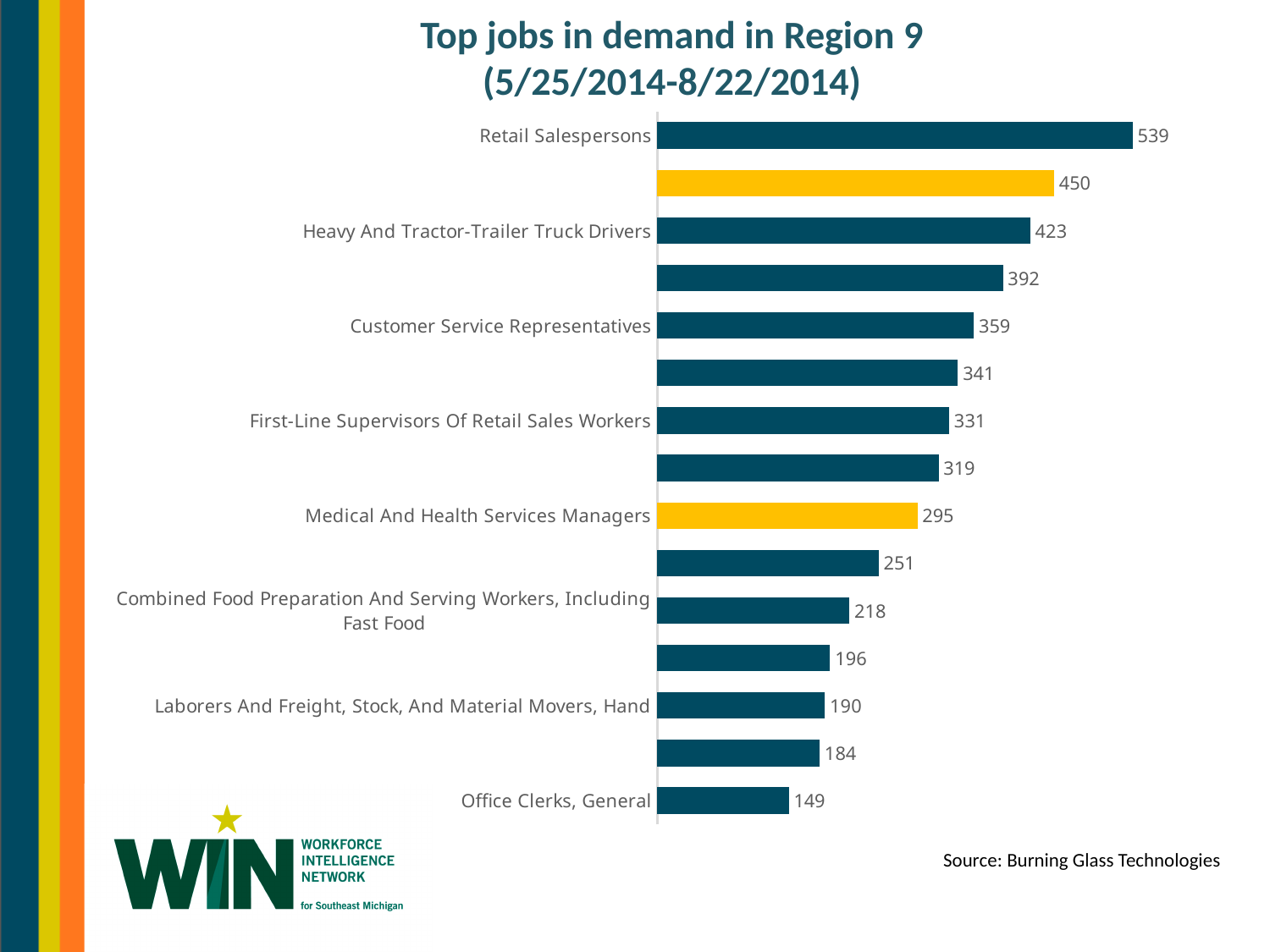
Which job has the highest value on the chart? Retail Salespersons What is the value for Office Clerks, General? 149 How many bars are plotted on the chart? 15 What is the title of the chart? Top jobs in demand in Region 9 (5/25/2014-8/22/2014) Which is larger, the value for First-Line Supervisors Of Retail Sales Workers or the value for Laborers And Freight, Stock, And Material Movers, Hand? First-Line Supervisors Of Retail Sales Workers What is the difference between the values for Retail Salespersons and Heavy And Tractor-Trailer Truck Drivers? 116 What kind of chart is shown on the slide? bar chart What is the value for Customer Service Representatives? 359 Which job has the lowest value on the chart? Office Clerks, General What is the value for Retail Salespersons? 539 What is the value for Medical And Health Services Managers? 295 What is the value for Heavy And Tractor-Trailer Truck Drivers? 423